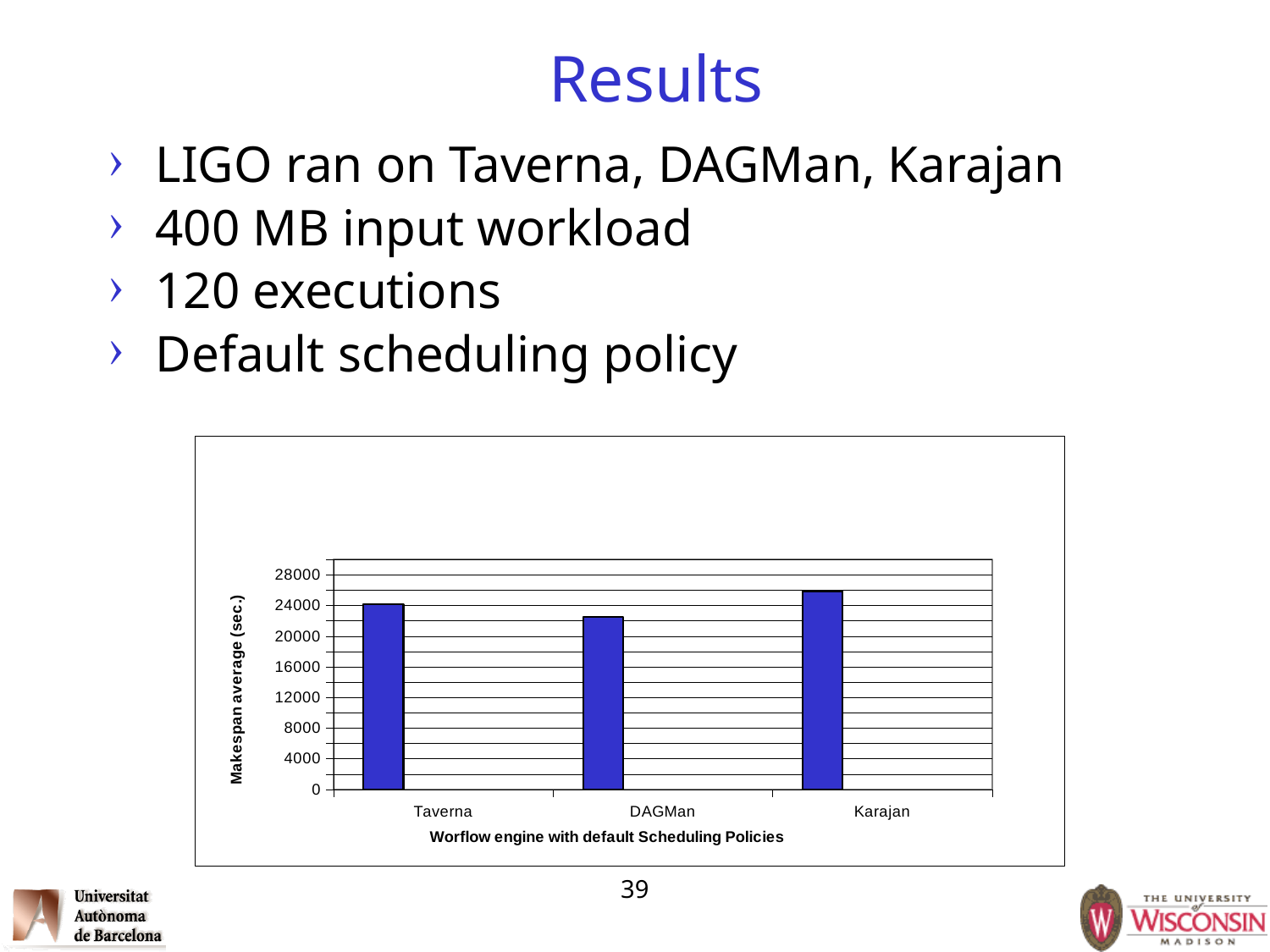
Which workflow engine has the highest makespan average? Karajan How many workflow engines are plotted on the x axis of the chart? 3 What is the label of the y axis of the chart? Makespan average (sec.) Is the makespan average for Taverna greater or less than 20000? greater What kind of chart is shown on the slide? bar chart Is the makespan average for Karajan greater or less than 28000? less Is the makespan average for DAGMan greater or less than 24000? less Which has a larger makespan average, Taverna or DAGMan? Taverna Which workflow engine has the lowest makespan average? DAGMan Which has a larger makespan average, Karajan or Taverna? Karajan What is the label of the x axis of the chart? Worflow engine with default Scheduling Policies